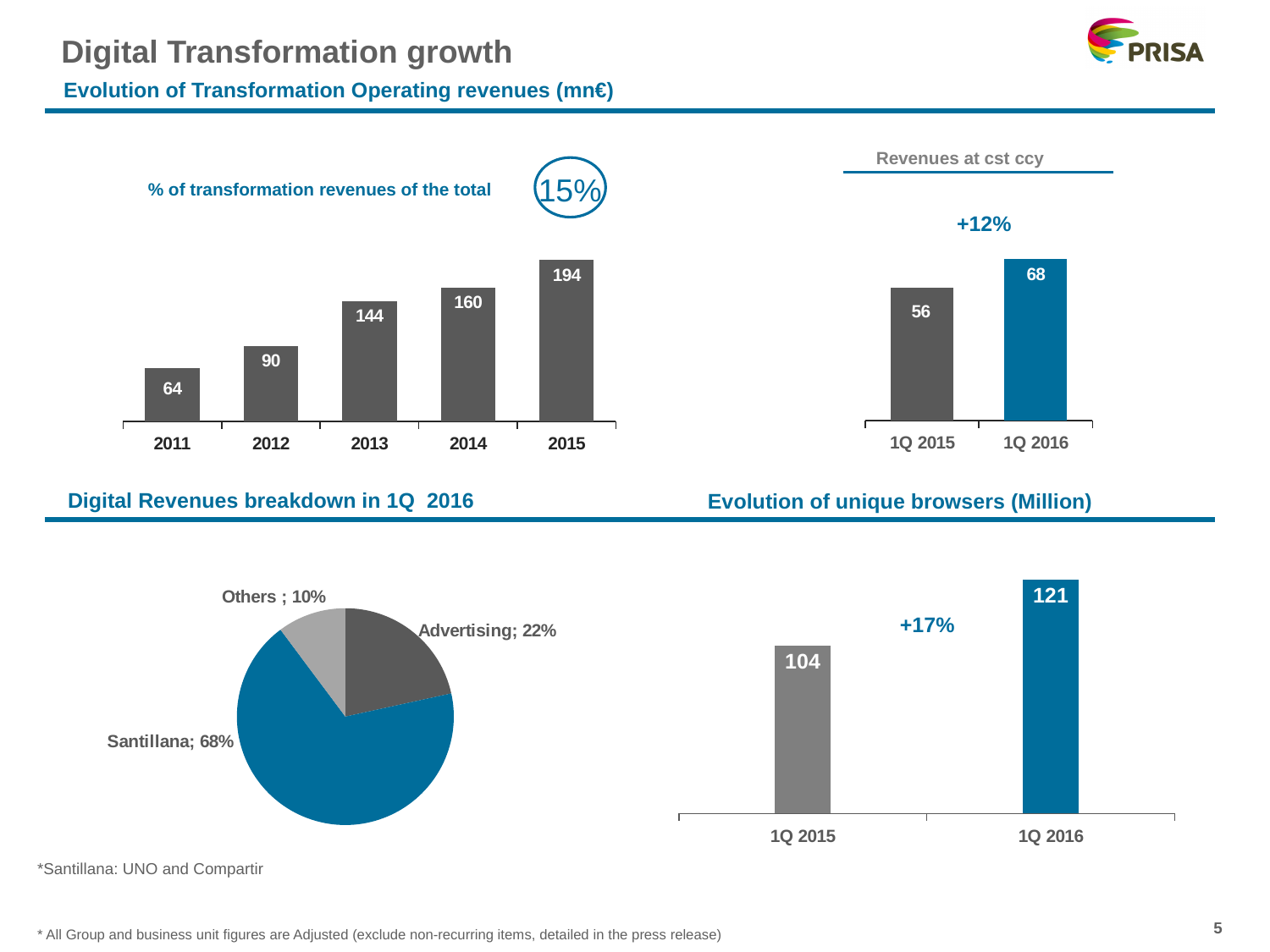
In the 'Revenues at cst ccy' chart, what is the difference between 1Q 2016 and 1Q 2015? 12 In the 'Digital Revenues breakdown in 1Q 2016' pie chart, which slice is the smallest? Others In the top-left chart of Transformation Operating revenues by year, do the values rise or fall from 2011 to 2015? rise In the top-left chart of Transformation Operating revenues by year, how many years are shown? 5 In the 'Digital Revenues breakdown in 1Q 2016' pie chart, what share does Santillana have? 68% In the top-left chart of Transformation Operating revenues by year, what is the difference between the 2015 and 2011 values? 130 In the 'Evolution of unique browsers (Million)' chart, what is the value for 1Q 2015? 104 In the 'Revenues at cst ccy' chart, what is the value for 1Q 2016? 68 What kind of chart is 'Evolution of unique browsers (Million)'? bar chart In the top-left chart of Transformation Operating revenues by year, which year has the highest value? 2015 In the top-left chart of Transformation Operating revenues by year, what is the value for 2013? 144 In the 'Digital Revenues breakdown in 1Q 2016' pie chart, how many slices are there? 3